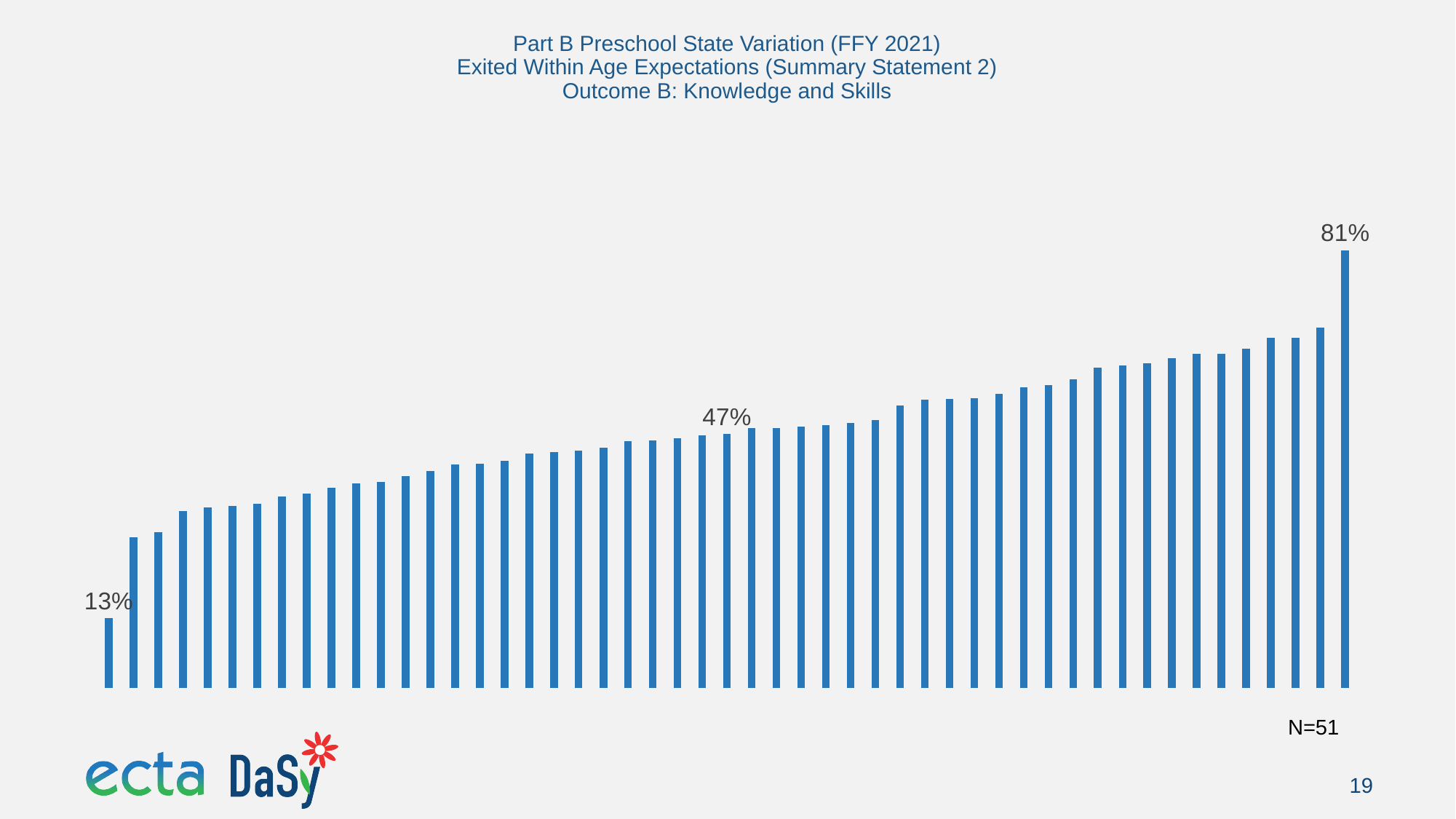
Is the value of the tallest bar greater or less than 50%? greater Which federal fiscal year does the chart title refer to? FFY 2021 What kind of chart is shown on the slide? bar chart What value is labelled on the middle bar of the chart? 47% What is the highest value labelled on the chart? 81% Which is larger, the value of the leftmost bar or the value of the rightmost bar? the rightmost bar Do the bar values rise or fall from left to right across the chart? rise Which outcome does the chart title say the data is for? Outcome B: Knowledge and Skills How many states are included in the chart, according to the N shown on the slide? 51 What is the difference between the highest labelled value (81%) and the lowest labelled value (13%)? 68 percentage points Is the value of the shortest bar greater or less than 20%? less What is the lowest value labelled on the chart? 13%